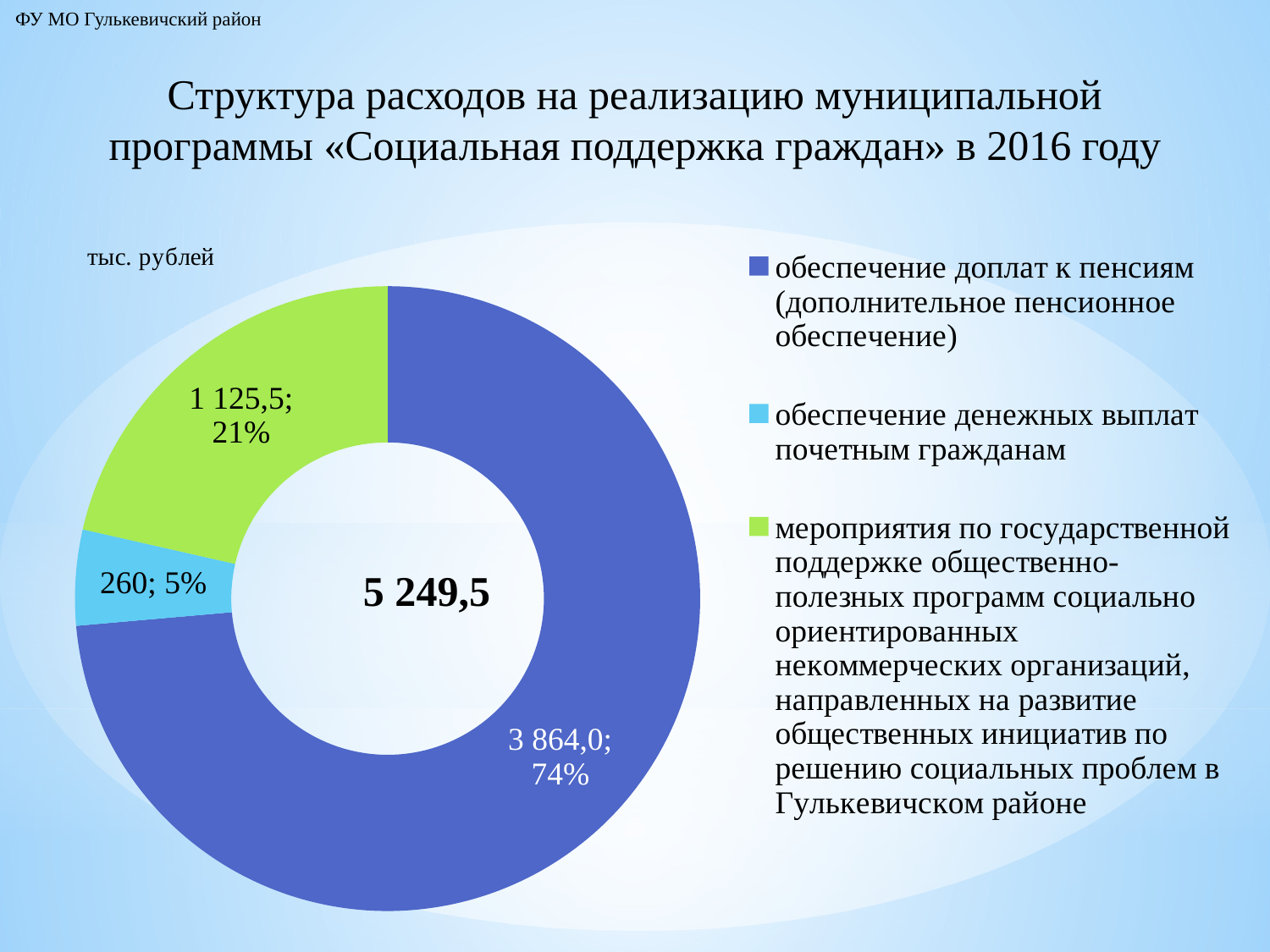
Which category has the largest value? обеспечение доплат к пенсиям (дополнительное пенсионное обеспечение) Which category has the smallest value? обеспечение денежных выплат почетным гражданам What is the value for "обеспечение денежных выплат почетным гражданам"? 260 How many slices does the chart have? 3 What share of the chart does "обеспечение доплат к пенсиям" take? 74% What share of the chart does the green slice (мероприятия по государственной поддержке...) take? 21% What kind of chart is shown on the slide? doughnut chart What is the value for "мероприятия по государственной поддержке общественно-полезных программ социально ориентированных некоммерческих организаций..."? 1 125,5 What share of the chart does "обеспечение денежных выплат почетным гражданам" take? 5% What total value is printed in the centre of the chart? 5 249,5 What is the difference between the value for "обеспечение доплат к пенсиям" and the value for "мероприятия по государственной поддержке..."? 2 738,5 What is the value for "обеспечение доплат к пенсиям (дополнительное пенсионное обеспечение)"? 3 864,0